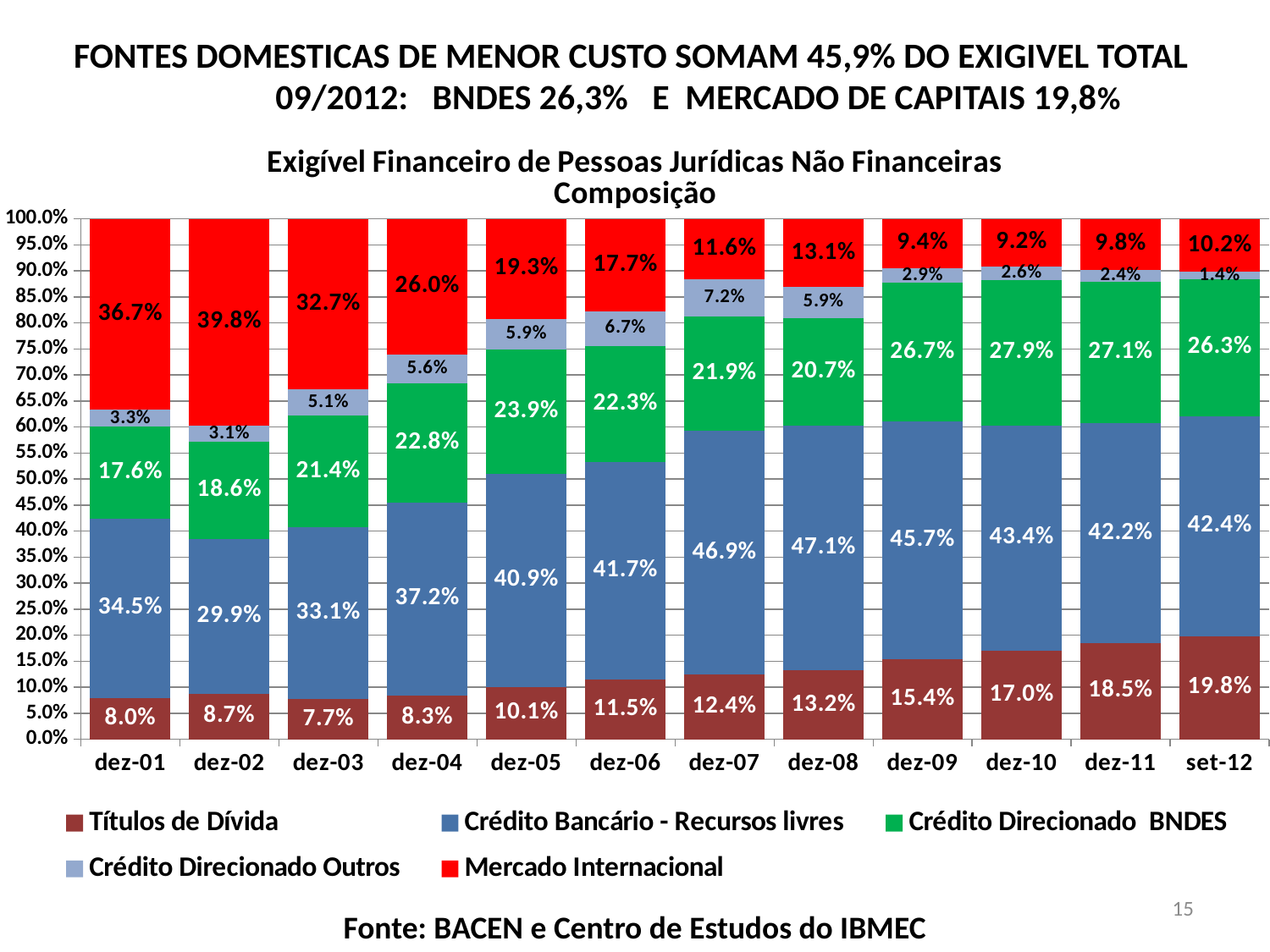
What is the value for Mercado Internacional in dez-02? 39.8% What is the value for Crédito Direcionado Outros in dez-07? 7.2% What is the value for Títulos de Dívida in set-12? 19.8% Which is larger, the Mercado Internacional value for dez-01 or for dez-03? dez-01 What is the value for Crédito Direcionado BNDES in dez-10? 27.9% Does the Mercado Internacional share generally rise or fall from dez-02 to set-12? Fall What is the difference between the Crédito Bancário - Recursos livres values for dez-08 and dez-01? 12.6 percentage points In which period is the Títulos de Dívida share lowest? dez-03 In which period is the Mercado Internacional share highest? dez-02 How many periods are shown on the x axis? 12 What kind of chart is shown? Stacked bar chart How many series does the legend list? 5